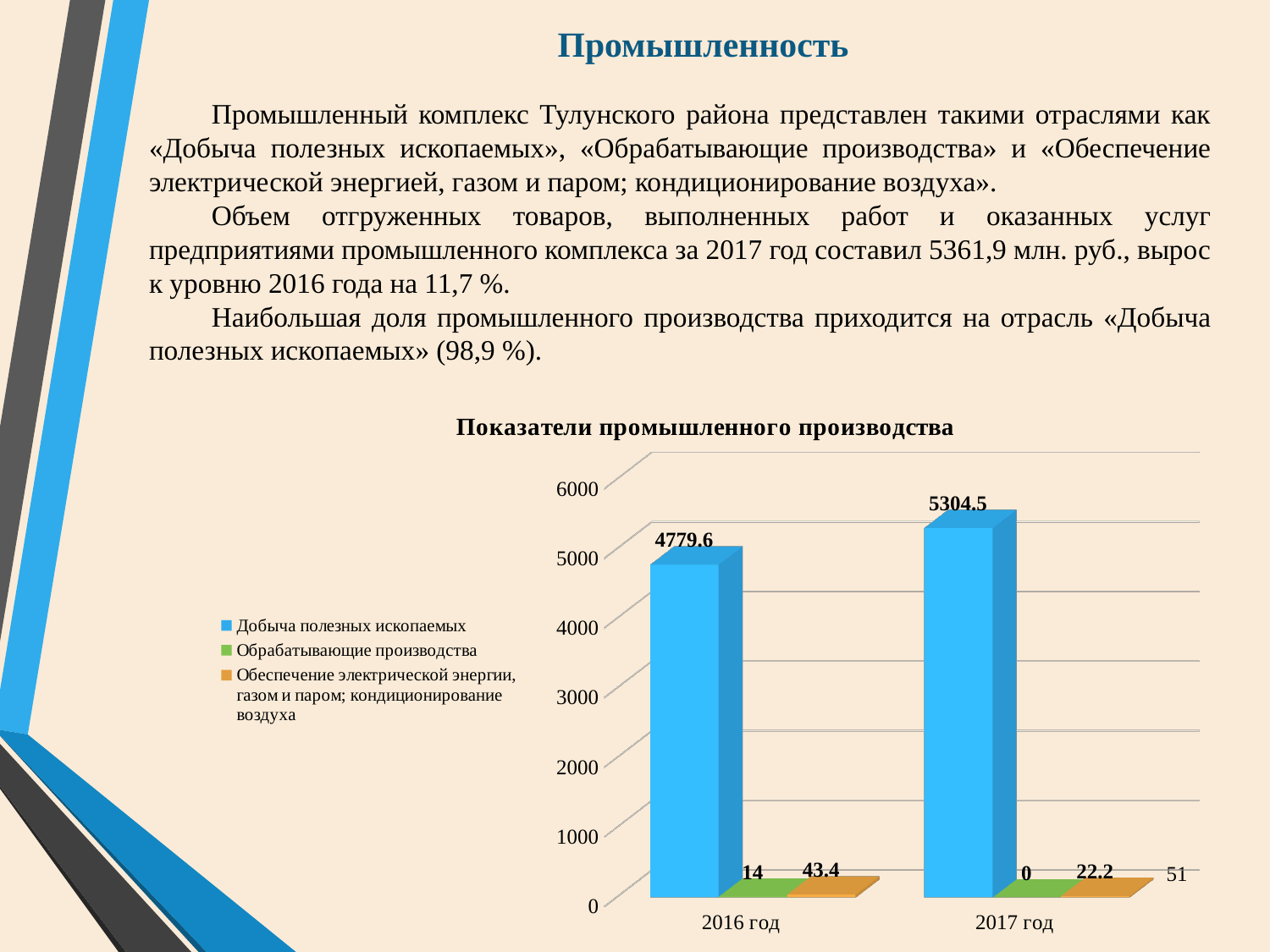
What is the title of the chart? Показатели промышленного производства How many categories are shown on the x axis? 2 What is the value for Обрабатывающие производства in 2017 год? 0 What kind of chart is shown on the slide? Bar chart What is the value for Обрабатывающие производства in 2016 год? 14 How many series does the legend list? 3 What is the value for Обеспечение электрической энергии, газом и паром; кондиционирование воздуха in 2017 год? 22.2 What is the value for Добыча полезных ископаемых in 2017 год? 5304.5 What is the value for Добыча полезных ископаемых in 2016 год? 4779.6 By how much did the value for Добыча полезных ископаемых change from 2016 год to 2017 год? 524.9 Is the value for Добыча полезных ископаемых in 2017 год greater or less than 5000? greater Which year has the higher value for Добыча полезных ископаемых, 2016 год or 2017 год? 2017 год